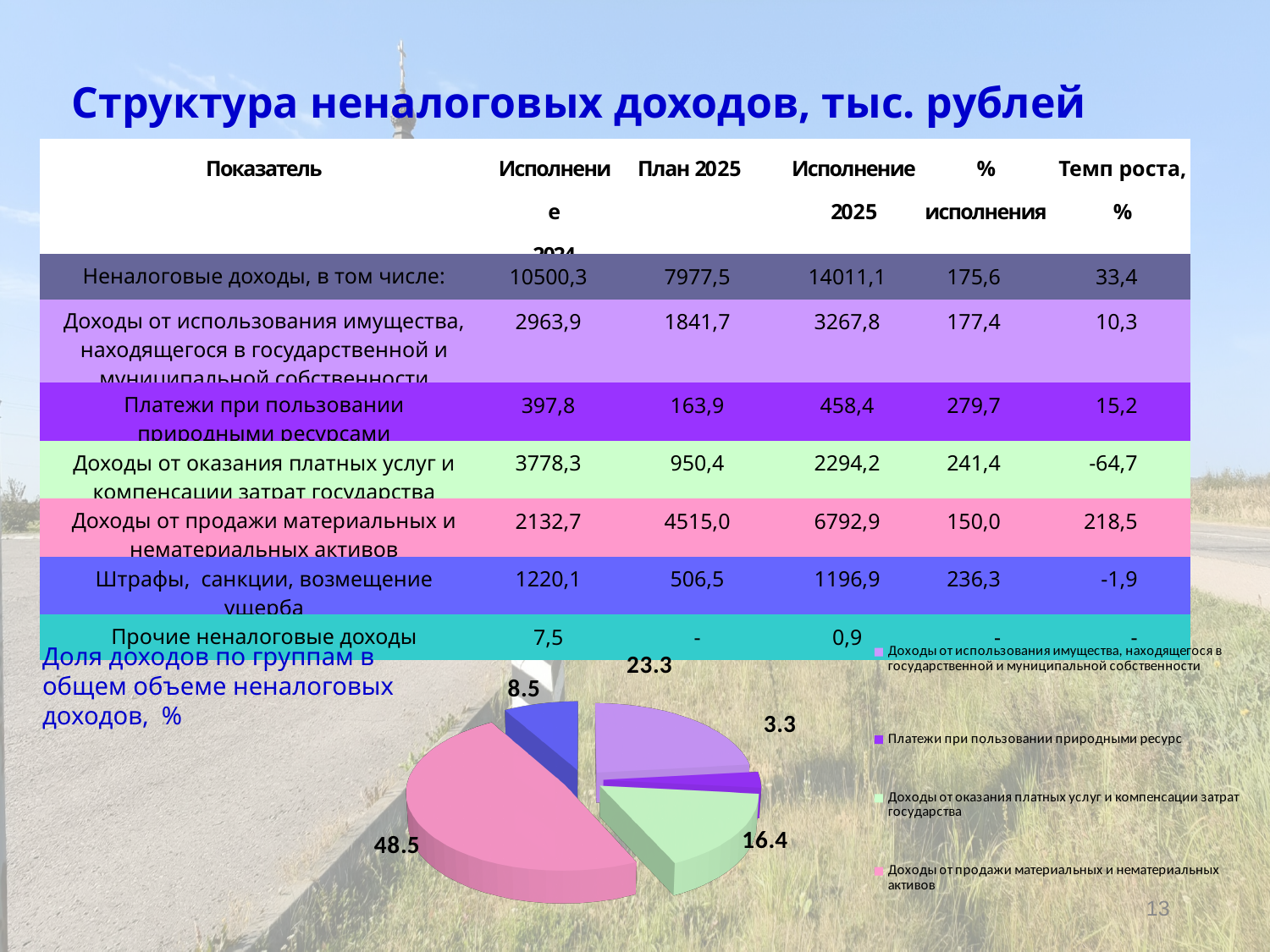
What is the title of the pie chart? Доля доходов по группам в общем объеме неналоговых доходов, % How many slices does the pie chart have? 5 What kind of chart is shown on the slide? Pie chart What share does the pie chart show for 'Доходы от оказания платных услуг и компенсации затрат государства'? 16.4 What share does the pie chart show for 'Платежи при пользовании природными ресурс'? 3.3 What share does the pie chart show for 'Доходы от продажи материальных и нематериальных активов'? 48.5 Which category has the largest slice in the pie chart? Доходы от продажи материальных и нематериальных активов In the pie chart, which is larger: the slice for 'Доходы от использования имущества' or the slice for 'Доходы от оказания платных услуг'? Доходы от использования имущества What is the difference between the pie chart shares for 'Доходы от использования имущества' (23.3) and 'Доходы от оказания платных услуг' (16.4)? 6.9 Which category has the smallest slice in the pie chart? Платежи при пользовании природными ресурс What share does the pie chart show for 'Доходы от использования имущества, находящегося в государственной и муниципальной собственности'? 23.3 What colour is the slice for 'Доходы от продажи материальных и нематериальных активов' in the pie chart? Pink